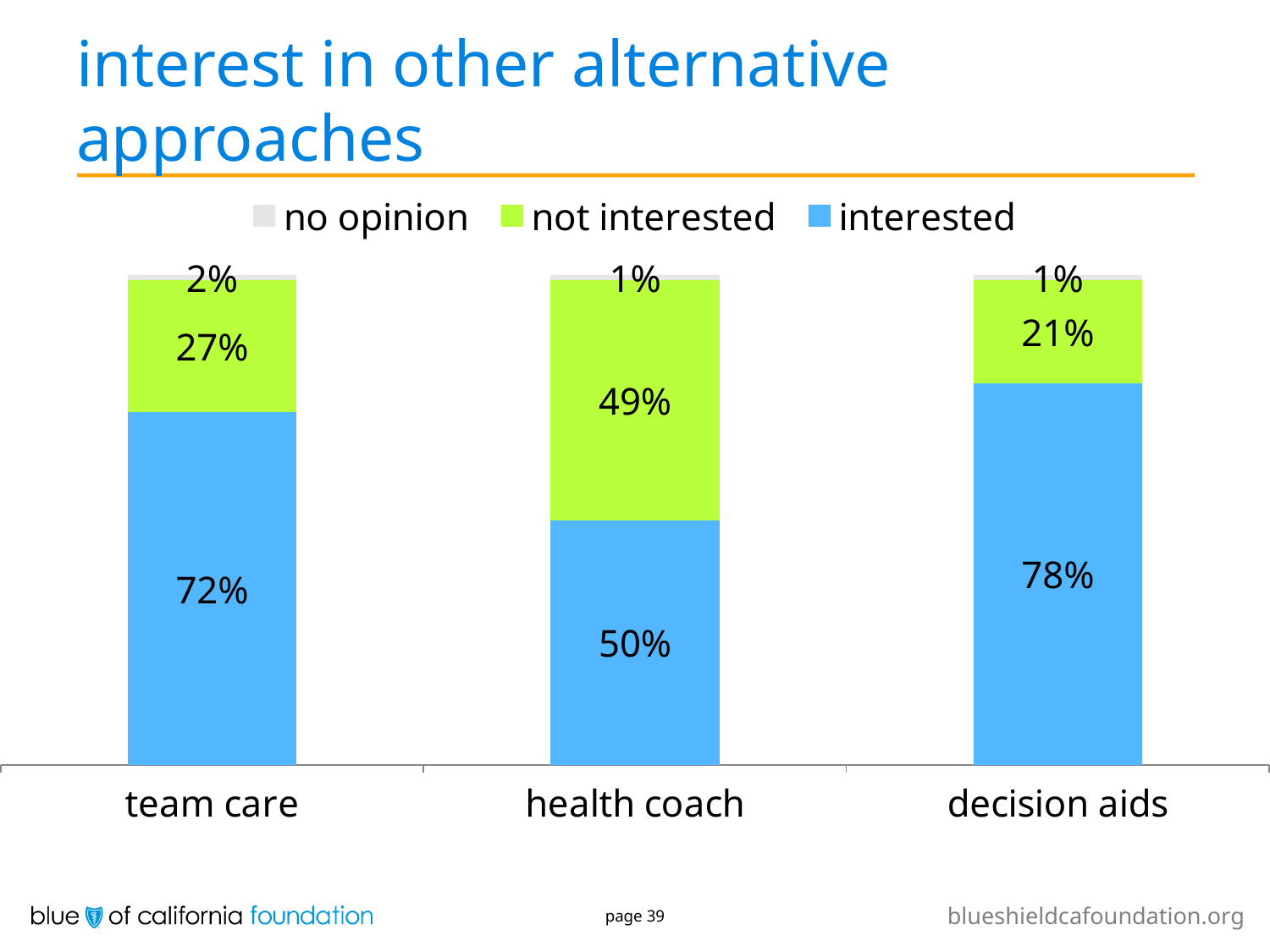
What percentage of respondents have no opinion on decision aids? 1% What kind of chart is shown on the slide? stacked bar chart Which colour represents the interested series in the legend? blue Is the not interested share larger for team care or for decision aids? team care What is the difference between the interested share for decision aids and for team care? 6% How many approaches are shown on the x axis? 3 Which approach has the lowest share of interested respondents? health coach Which approach has the highest share of interested respondents? decision aids How many series does the legend list? 3 What is the total of the stacked bar for health coach? 100% What percentage of respondents are interested in team care? 72% What percentage of respondents are not interested in a health coach? 49%